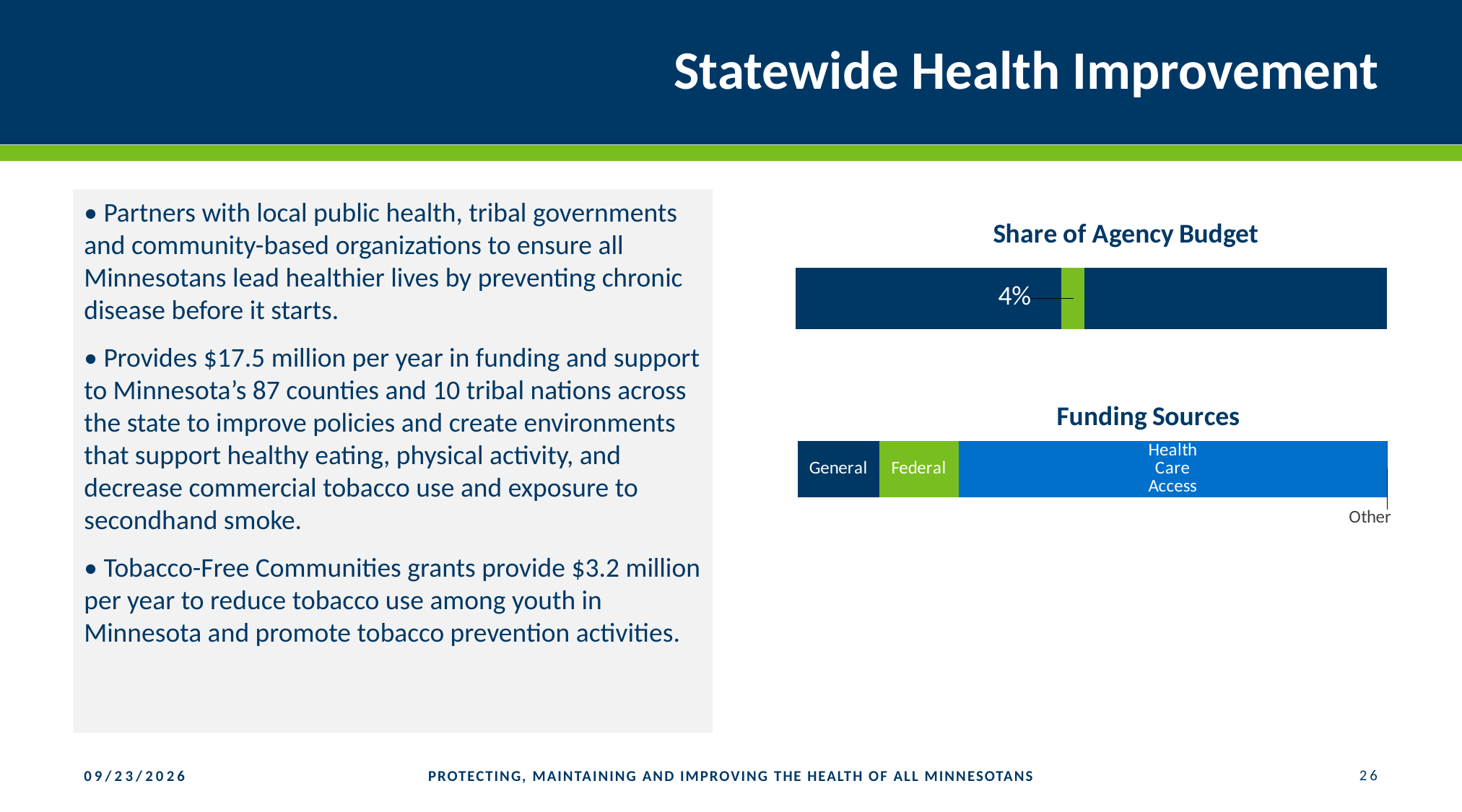
In the Share of Agency Budget chart, what percentage is labeled on the highlighted segment? 4% In the Funding Sources chart, which segment is larger, Federal or Health Care Access? Health Care Access What kind of chart is the Funding Sources chart? bar chart In the Funding Sources chart, which segment is larger, General or Health Care Access? Health Care Access What kind of chart is the Share of Agency Budget chart? bar chart In the Funding Sources chart, which funding source has the smallest segment? Other In the Funding Sources chart, what colour is the Federal segment? green In the Funding Sources chart, how many funding source segments are shown? 4 In the Funding Sources chart, which funding source has the largest segment? Health Care Access What is the title of the upper chart on the slide? Share of Agency Budget